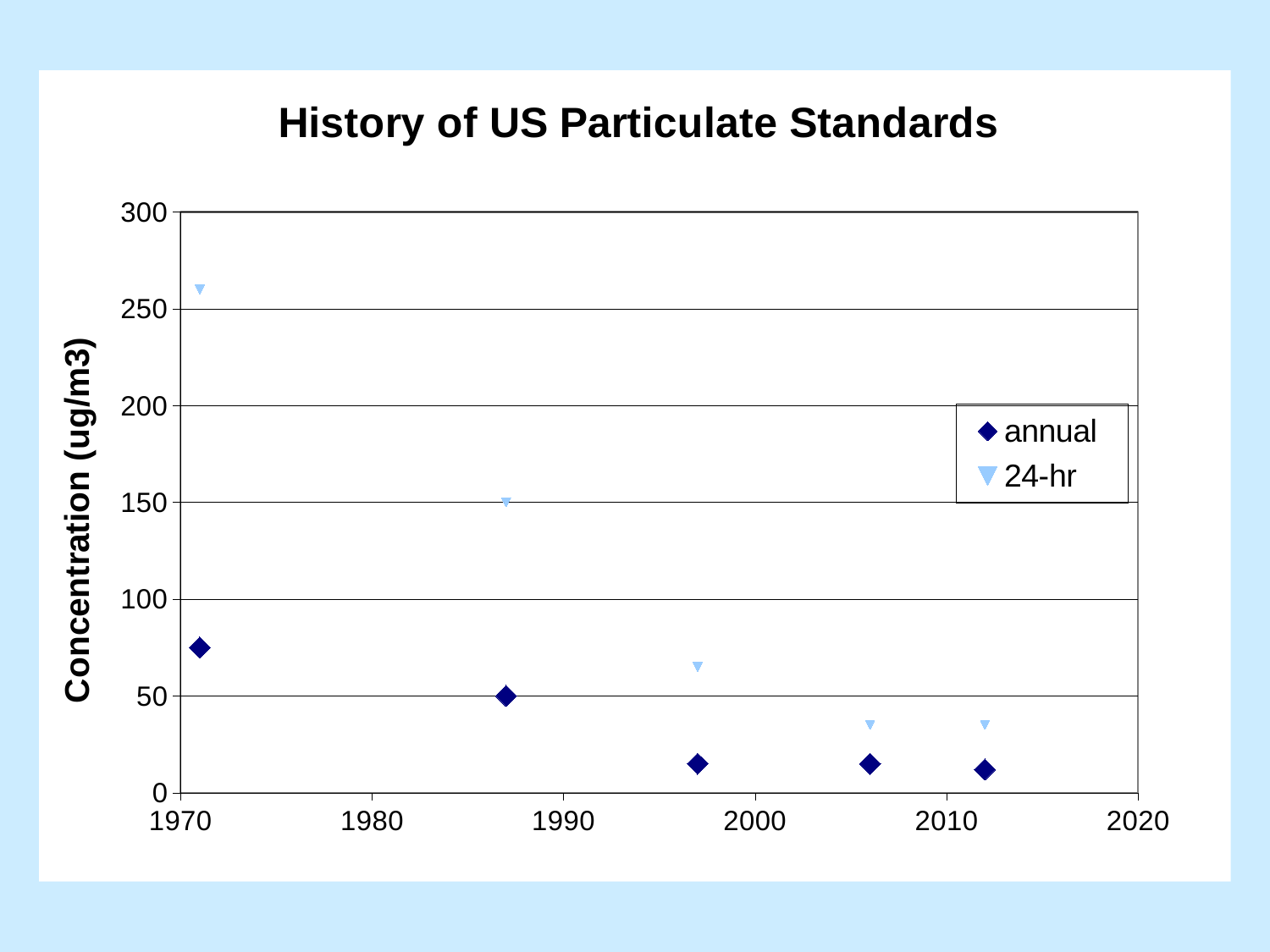
How many series does the legend list? 2 What kind of chart is shown on the slide? scatter chart What are the two series named in the legend? annual and 24-hr Do the annual standard values rise or fall over time along the x axis? fall Is the value of the rightmost annual point (around 2012) greater or less than 50? less At the leftmost year (around 1971), which series has the higher value, annual or 24-hr? 24-hr Is the value of the leftmost annual point (around 1971) greater or less than 100? less Is the value of the leftmost 24-hr point (around 1971) greater or less than 250? greater How many data points are plotted for the 24-hr series? 5 Do the 24-hr standard values rise or fall over time along the x axis? fall How many data points are plotted for the annual series? 5 What is the label on the y axis? Concentration (ug/m3)